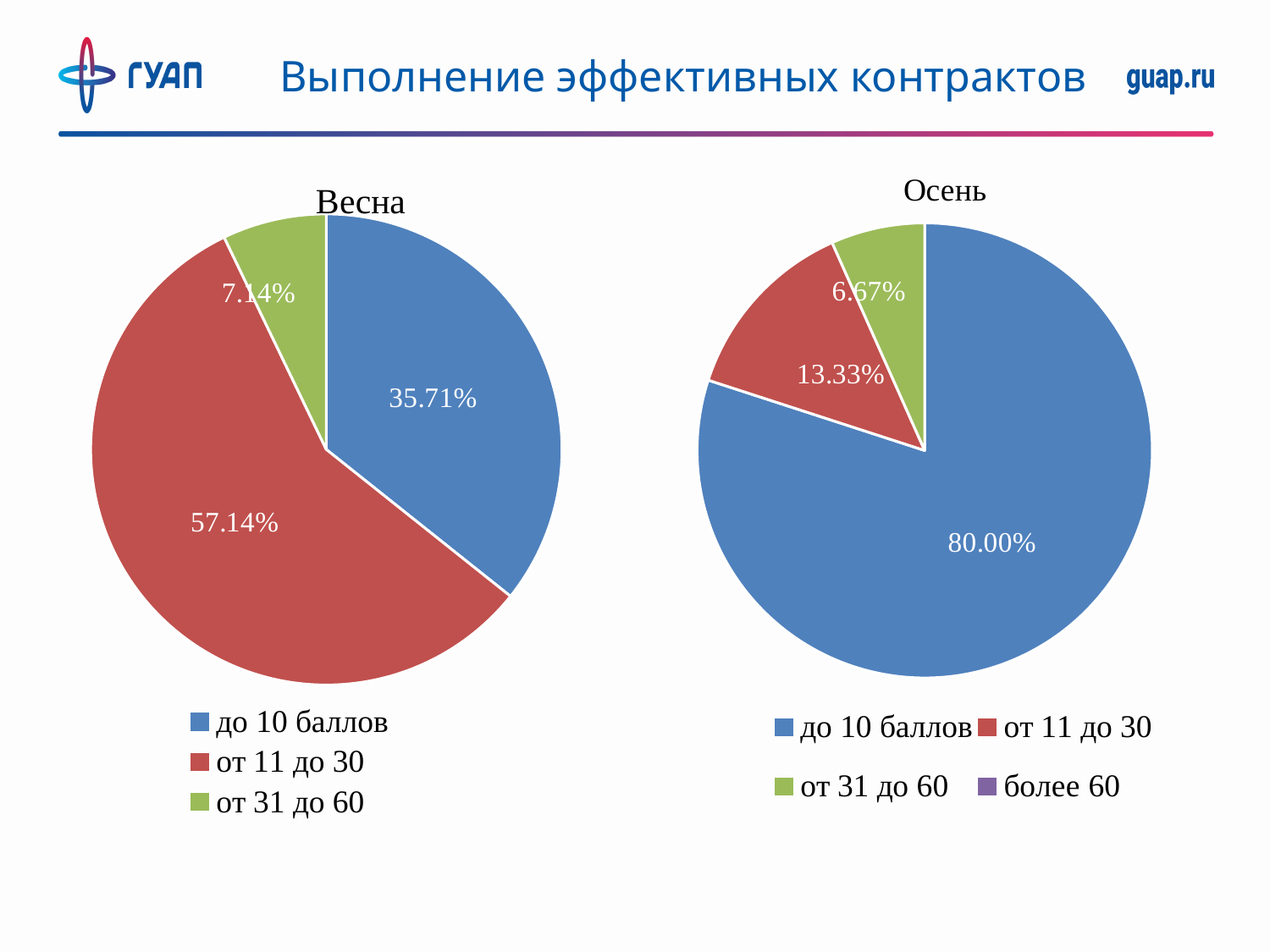
In the "Весна" chart, which category has the largest slice? от 11 до 30 In the "Весна" chart, what share is labelled for the "до 10 баллов" slice? 35.71% How many entries does the legend of the "Осень" chart list? 4 In the "Осень" chart, which category has the largest slice? до 10 баллов In the "Осень" chart, what share is labelled for the "от 31 до 60" slice? 6.67% In the "Весна" chart, which category has the smallest slice? от 31 до 60 In the "Осень" chart, what is the difference between the "от 11 до 30" and "от 31 до 60" shares? 6.66% In the "Осень" chart, what share is labelled for the "до 10 баллов" slice? 80.00% In the "Весна" chart, what colour is the "от 31 до 60" slice? Green What type of chart is the "Весна" chart? Pie chart Which is larger: the "до 10 баллов" share in the "Весна" chart or in the "Осень" chart? Осень In the "Весна" chart, what share is labelled for the "от 11 до 30" slice? 57.14%